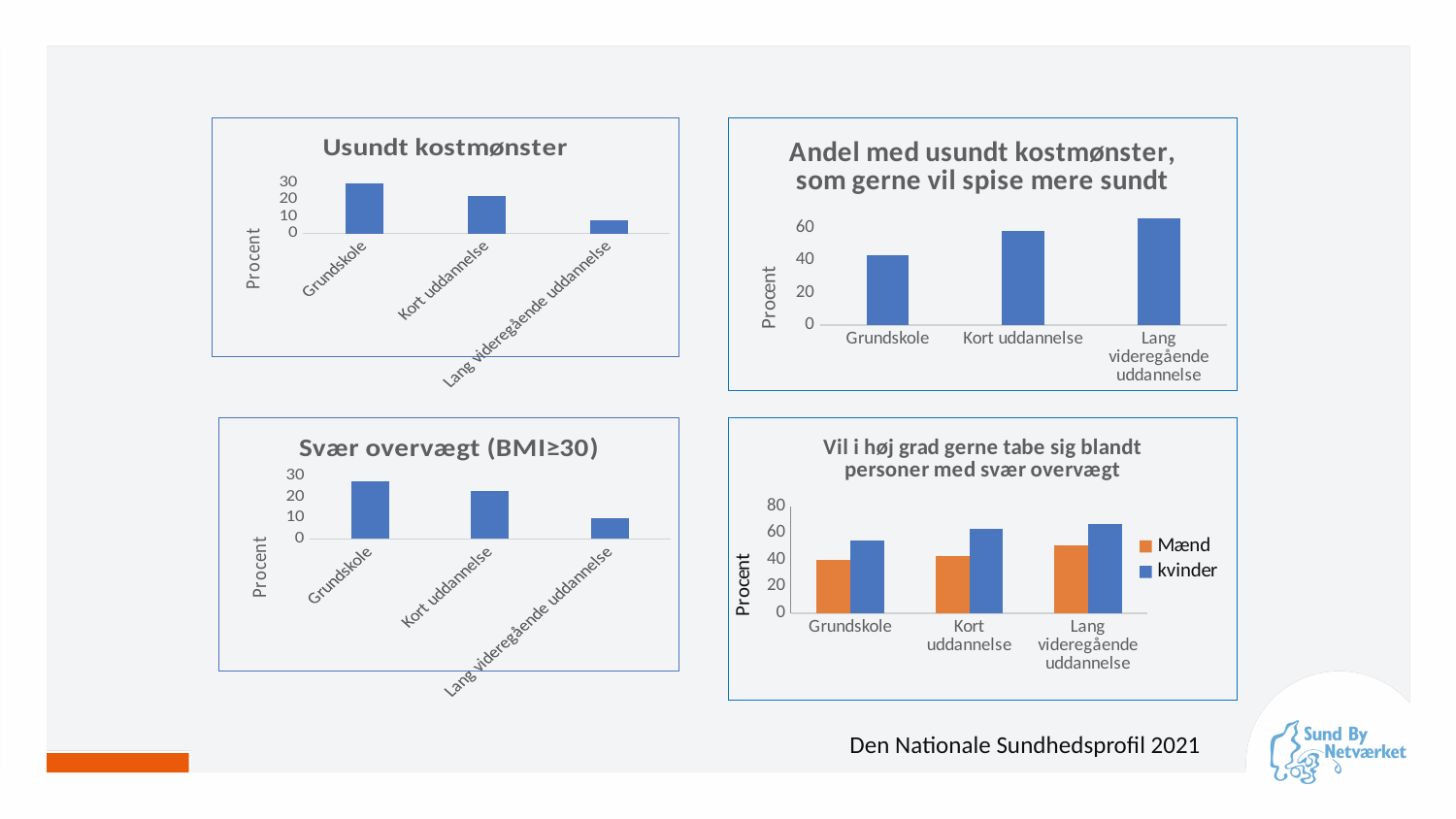
In the chart titled 'Usundt kostmønster', which category has the highest value? Grundskole In the chart titled 'Svær overvægt (BMI≥30)', is the value for Grundskole greater or less than 20? greater In the chart titled 'Usundt kostmønster', is the value for Lang videregående uddannelse greater or less than 10? less In the chart titled 'Andel med usundt kostmønster, som gerne vil spise mere sundt', is the value for Grundskole greater or less than 60? less In the chart titled 'Vil i høj grad gerne tabe sig blandt personer med svær overvægt', which is larger for Grundskole: Mænd or kvinder? kvinder In the chart titled 'Andel med usundt kostmønster, som gerne vil spise mere sundt', which category has the highest value? Lang videregående uddannelse What kind of chart is the one titled 'Vil i høj grad gerne tabe sig blandt personer med svær overvægt'? bar chart In the chart titled 'Svær overvægt (BMI≥30)', which category has the lowest value? Lang videregående uddannelse In the chart titled 'Svær overvægt (BMI≥30)', how many categories are shown on the x axis? 3 In the chart titled 'Andel med usundt kostmønster, som gerne vil spise mere sundt', do the values rise or fall from Grundskole to Lang videregående uddannelse? rise In the chart titled 'Usundt kostmønster', which category has the lowest value? Lang videregående uddannelse In the chart titled 'Vil i høj grad gerne tabe sig blandt personer med svær overvægt', how many series does the legend list? 2